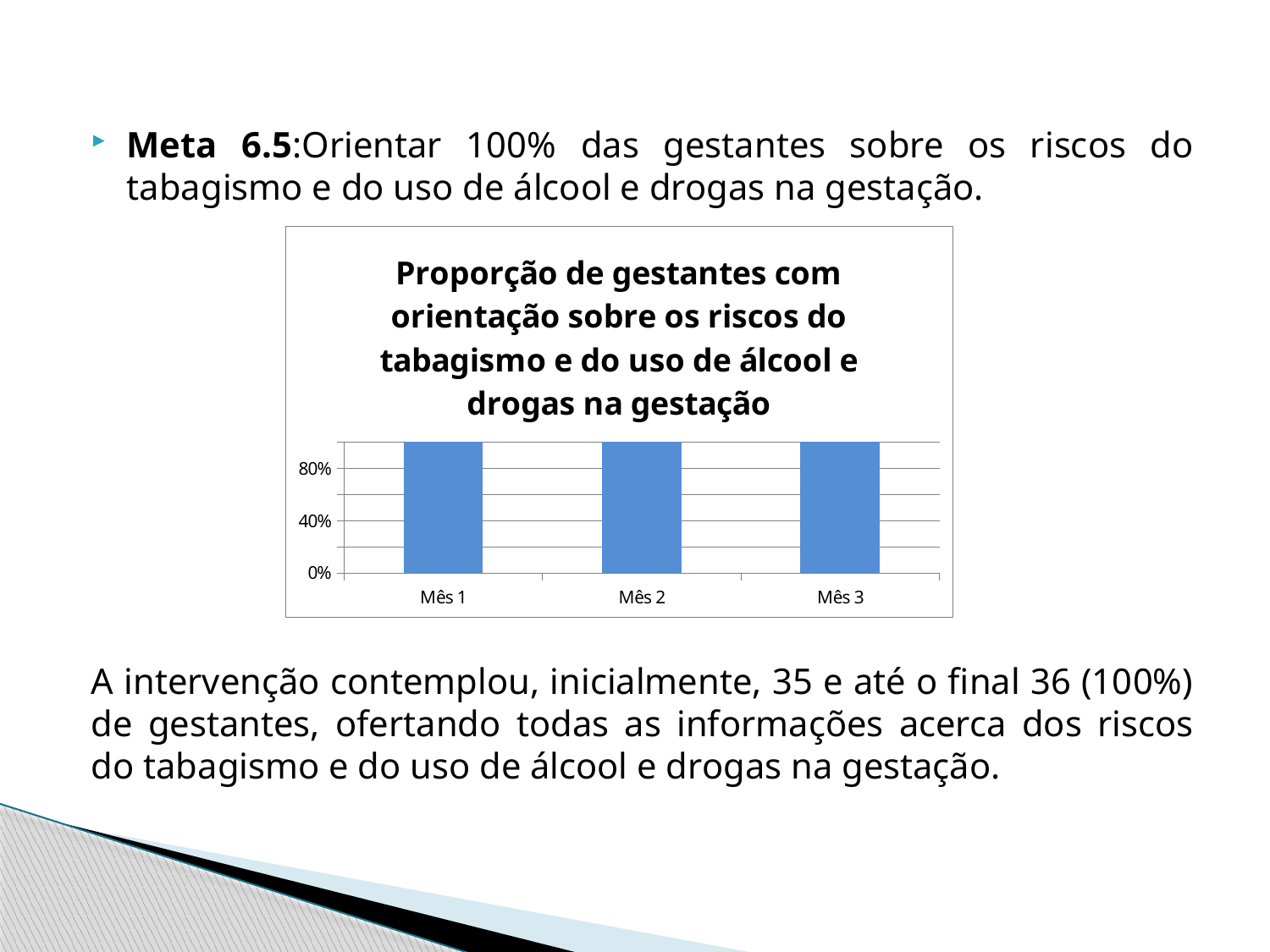
Is the value for Mês 2 greater or less than 80%? greater What is the label of the first category on the x axis? Mês 1 What is the title of the chart? Proporção de gestantes com orientação sobre os riscos do tabagismo e do uso de álcool e drogas na gestação Do the values rise, fall, or stay the same from Mês 1 to Mês 3? stay the same How many categories (months) are shown on the x axis of the chart? 3 What is the lowest tick value shown on the y axis of the chart? 0% Is the value for Mês 3 greater or less than 40%? greater What kind of chart is shown on the slide? bar chart Is the value for Mês 1 greater or less than 80%? greater